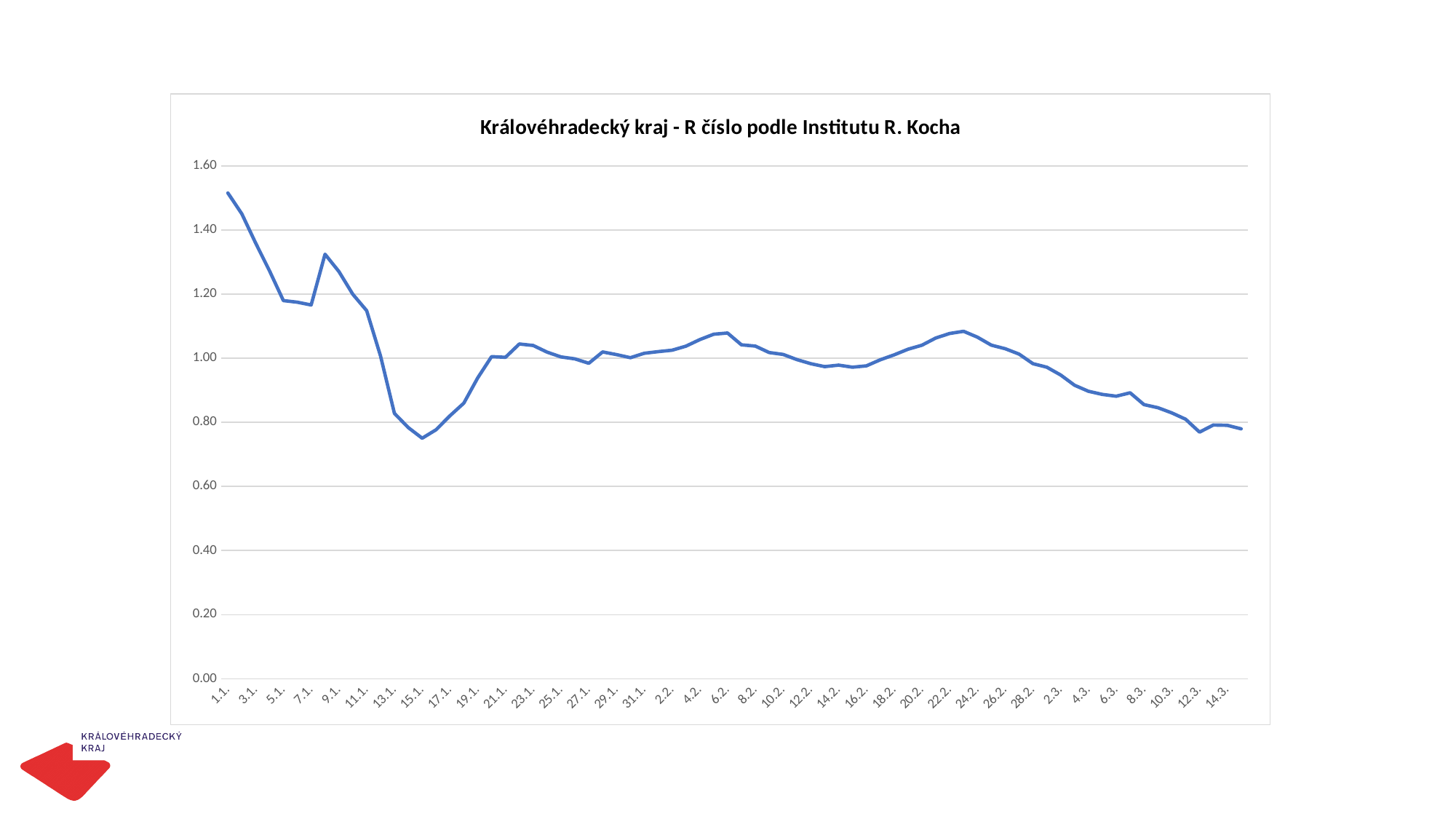
Is the value for 6.2. greater or less than 1.00? greater Is the value for 15.1. greater or less than 0.80? less Is the value for 17.1. greater or less than 1.00? less What kind of chart is shown on the slide? line chart Which is larger, the value for 1.1. or the value for 14.3.? 1.1. Overall, does the line rise or fall from 1.1. to 14.3.? fall What is the title of the chart? Královéhradecký kraj - R číslo podle Institutu R. Kocha On which date does the line reach its highest value? 1.1. How many date labels are shown on the x axis? 37